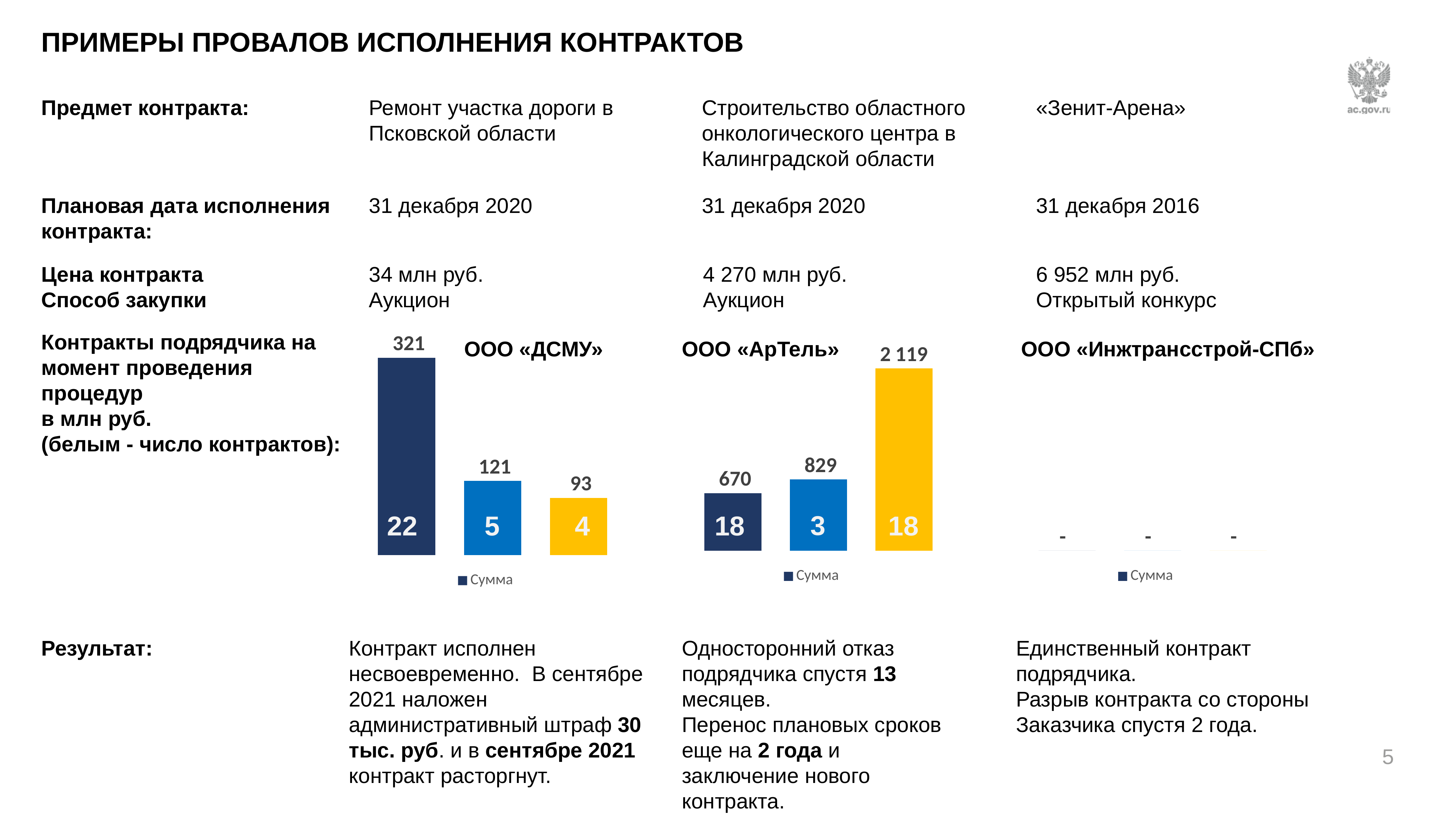
In the ООО «АрТель» chart, what is the difference between the blue bar (829) and the dark navy bar (670)? 159 In the ООО «ДСМУ» chart, do the bar values rise or fall from left to right? fall In the ООО «ДСМУ» chart, what is the value labelled on the tallest (dark navy) bar? 321 In the ООО «ДСМУ» chart, what is the value labelled on the yellow bar? 93 In the ООО «АрТель» chart, which bar is the lowest: the dark navy, blue or yellow one? dark navy (670) In the ООО «АрТель» chart, what number of contracts is printed in white on the blue bar? 3 In the ООО «АрТель» chart, do the bar values rise or fall from left to right? rise In the ООО «ДСМУ» chart, what is the difference between the dark navy bar (321) and the blue bar (121)? 200 In the ООО «АрТель» chart, what is the value labelled on the yellow bar? 2 119 How many bars are shown in the ООО «ДСМУ» chart? 3 In the ООО «ДСМУ» chart, what number of contracts is printed in white on the dark navy bar? 22 What kind of chart is used for ООО «АрТель»? bar chart